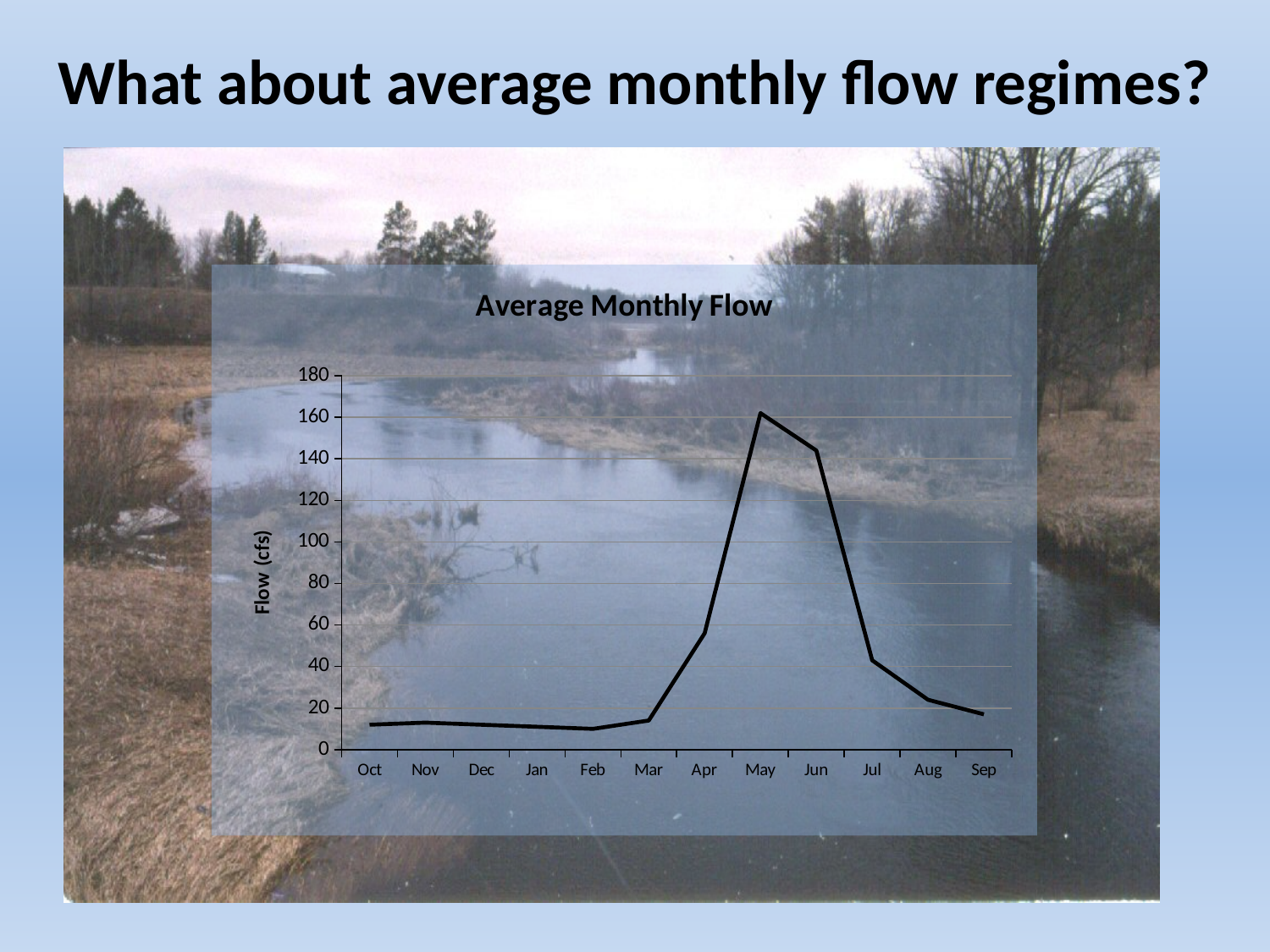
Which is larger, the flow in Apr or the flow in Jul? Apr What is the title of the chart? Average Monthly Flow Which is larger, the flow in May or the flow in Jun? May What is the label of the vertical axis? Flow (cfs) Is the value for May greater or less than 140? greater Is the value for Oct greater or less than 20? less Do the values rise or fall from May to Sep? fall Which month has the highest average flow? May Is the value for Jul greater or less than 60? less How many months are plotted along the x axis? 12 What kind of chart is shown on the slide? line chart